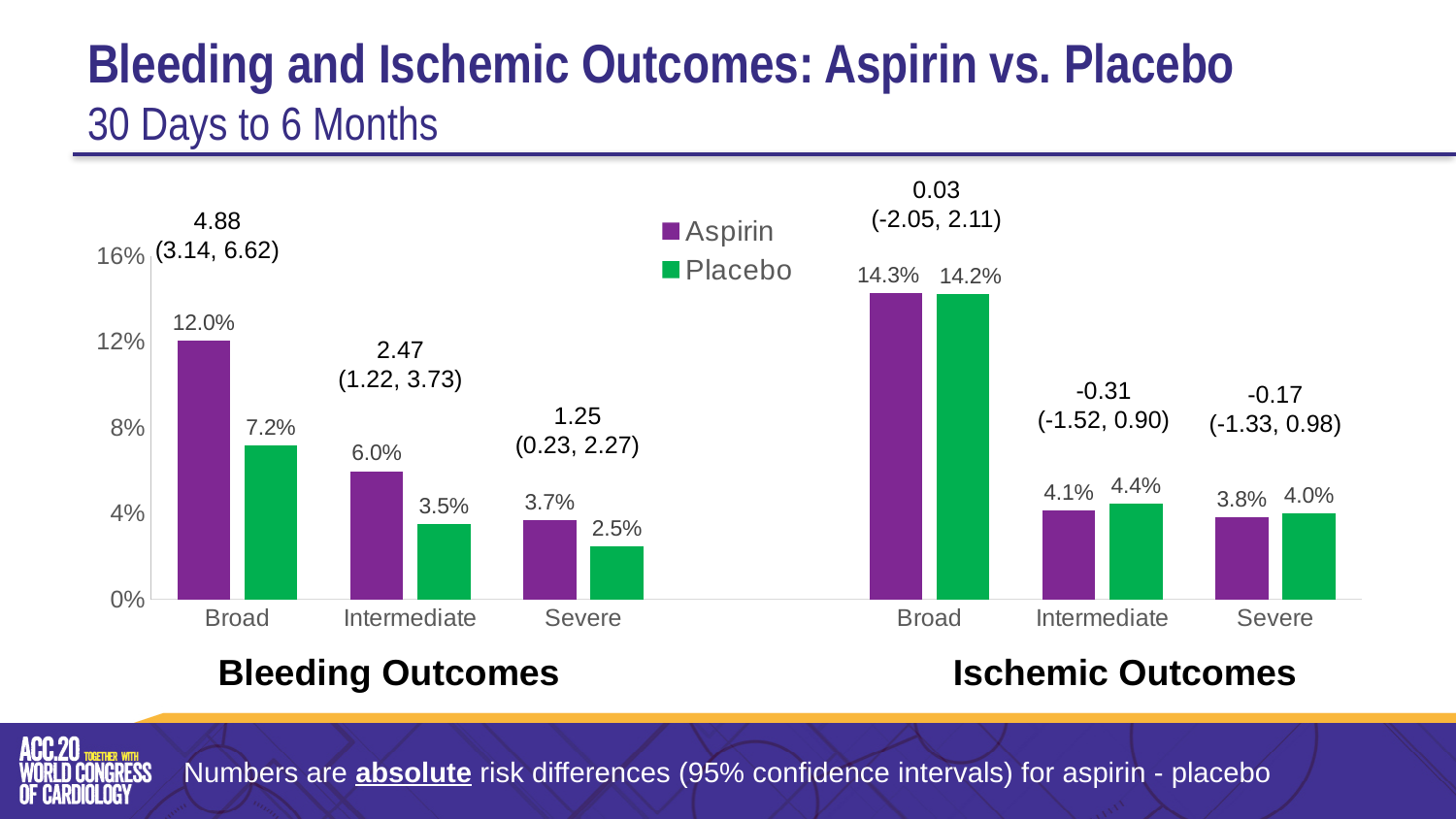
How many categories are shown on the x axis of the Ischemic Outcomes chart? 3 In the Ischemic Outcomes chart, what is the Placebo value for Broad? 14.2% How many series does the legend list? 2 In the Bleeding Outcomes chart, which category has the lowest Placebo value? Severe In the Bleeding Outcomes chart, what is the difference between the Aspirin and Placebo values for Broad? 4.8% In the Bleeding Outcomes chart, which is larger for Severe: the Aspirin value or the Placebo value? Aspirin In the Bleeding Outcomes chart, what is the Aspirin value for Broad? 12.0% In the Ischemic Outcomes chart, what is the difference between the Placebo and Aspirin values for Intermediate? 0.3% In the Bleeding Outcomes chart, which category has the highest Aspirin value? Broad In the Bleeding Outcomes chart, what is the Placebo value for Intermediate? 3.5% In the Ischemic Outcomes chart, what is the Aspirin value for Severe? 3.8% What kind of chart is the Bleeding Outcomes chart? Bar chart